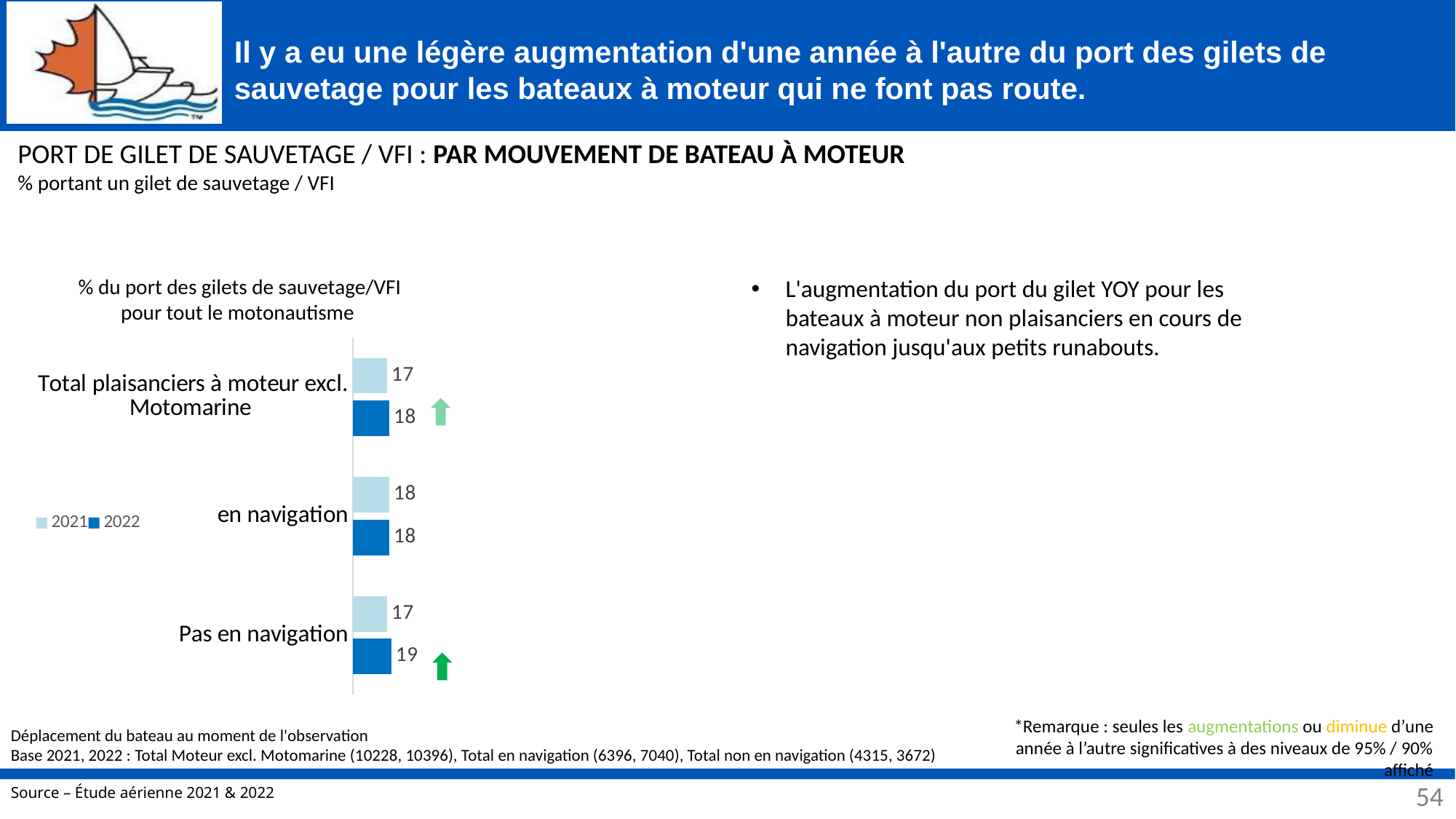
How many categories are shown in the chart? 3 What is the 2021 value for "Total plaisanciers à moteur excl. Motomarine"? 17 What is the 2022 value for "Total plaisanciers à moteur excl. Motomarine"? 18 What is the 2021 value for "en navigation"? 18 What is the difference between the 2022 and 2021 values for "en navigation"? 0 Which is larger for "Total plaisanciers à moteur excl. Motomarine": the 2021 value or the 2022 value? 2022 What is the difference between the 2022 and 2021 values for "Pas en navigation"? 2 Which category has the highest 2022 value? Pas en navigation Which series is shown in dark blue in the legend? 2022 What kind of chart is shown on the slide? Bar chart What is the 2022 value for "Pas en navigation"? 19 How many series does the legend list? 2